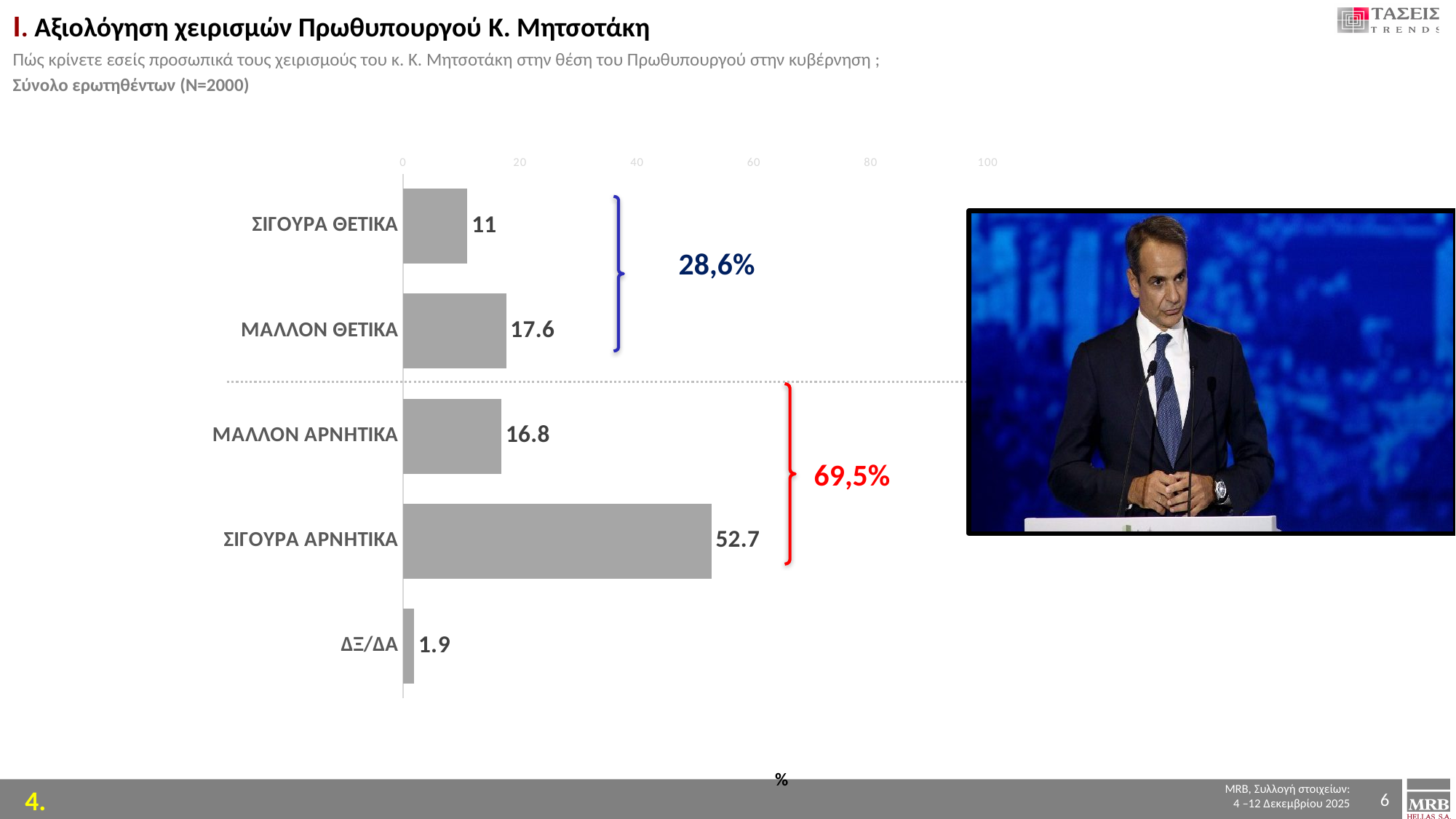
What is the value for ΣΙΓΟΥΡΑ ΘΕΤΙΚΑ? 11 Which is larger, the value for ΜΑΛΛΟΝ ΘΕΤΙΚΑ or the value for ΜΑΛΛΟΝ ΑΡΝΗΤΙΚΑ? ΜΑΛΛΟΝ ΘΕΤΙΚΑ What kind of chart is shown on the slide? bar chart What is the value for ΔΞ/ΔΑ? 1.9 How many categories are shown in the chart? 5 Which category has the lowest value? ΔΞ/ΔΑ What is the value for ΜΑΛΛΟΝ ΘΕΤΙΚΑ? 17.6 What is the value for ΣΙΓΟΥΡΑ ΑΡΝΗΤΙΚΑ? 52.7 What combined percentage is shown next to the red bracket grouping the negative categories? 69,5% Is the value for ΣΙΓΟΥΡΑ ΑΡΝΗΤΙΚΑ greater or less than 40? greater Which category has the highest value? ΣΙΓΟΥΡΑ ΑΡΝΗΤΙΚΑ What is the difference between the values for ΣΙΓΟΥΡΑ ΑΡΝΗΤΙΚΑ and ΜΑΛΛΟΝ ΑΡΝΗΤΙΚΑ? 35.9